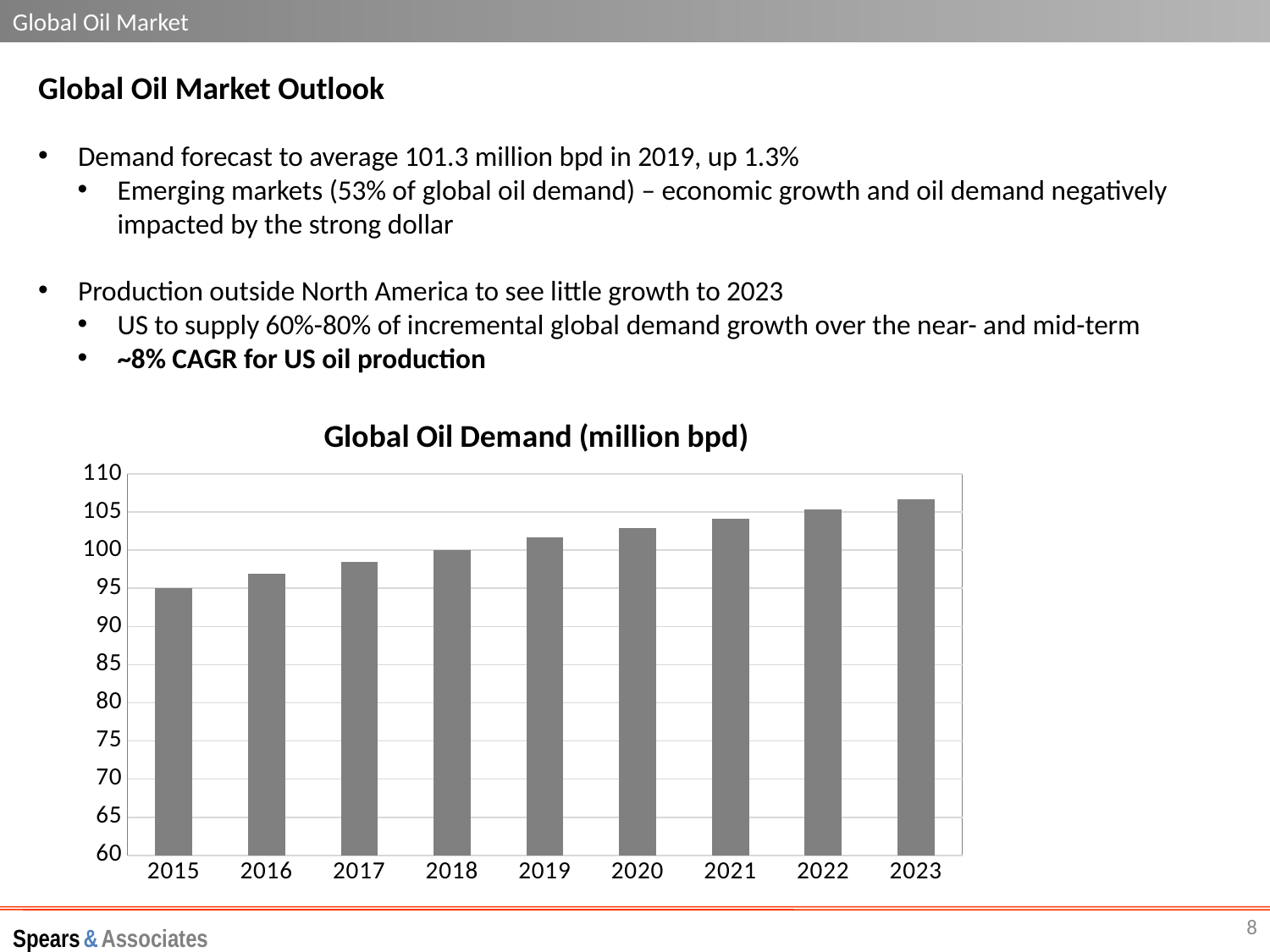
Which year has the lowest global oil demand in the chart? 2015 Is the value for 2021 greater or less than 100? greater Which year has the highest global oil demand in the chart? 2023 What is the highest value shown on the vertical axis of the chart? 110 Is the value for 2016 greater or less than 100? less Is the value for 2023 greater or less than 105? greater Which is larger, the value for 2023 or the value for 2015? 2023 Do the values in the Global Oil Demand chart rise or fall from 2015 to 2023? rise What is the title of the chart? Global Oil Demand (million bpd) How many years are plotted in the Global Oil Demand chart? 9 What kind of chart is shown on the slide? bar chart